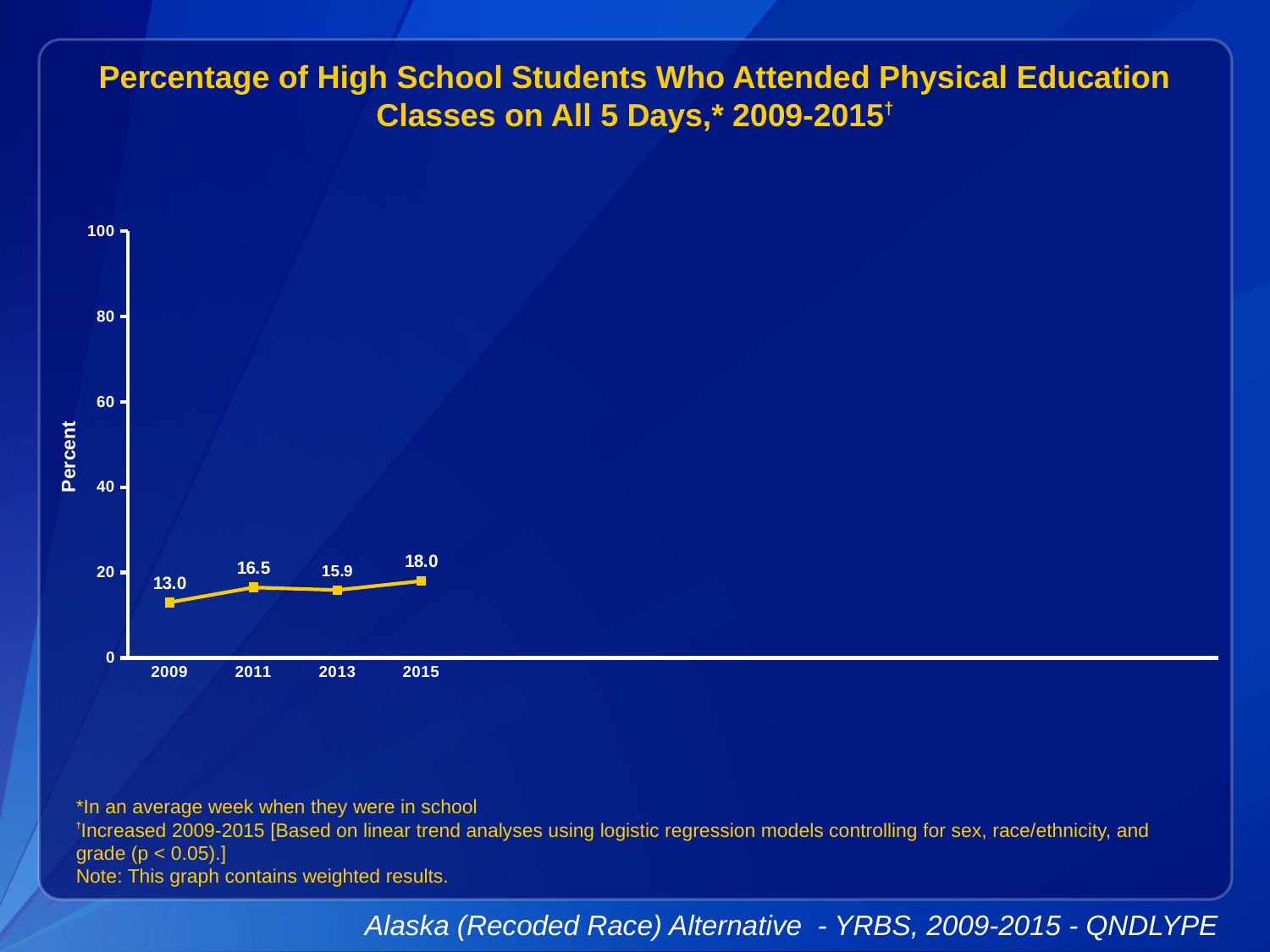
Overall, do the values rise or fall from 2009 to 2015? rise What is the value plotted for 2013? 15.9 Is the value for 2015 greater or less than 20? less What is the difference between the 2015 value and the 2009 value? 5.0 How many years are plotted on the chart? 4 What is the label on the vertical axis? Percent Which year has the lowest value? 2009 What is the value plotted for 2015? 18.0 Which year has the larger value, 2011 or 2013? 2011 What kind of chart is shown on the slide? line chart Which year has the highest value? 2015 What percentage of high school students attended physical education classes on all 5 days in 2009? 13.0